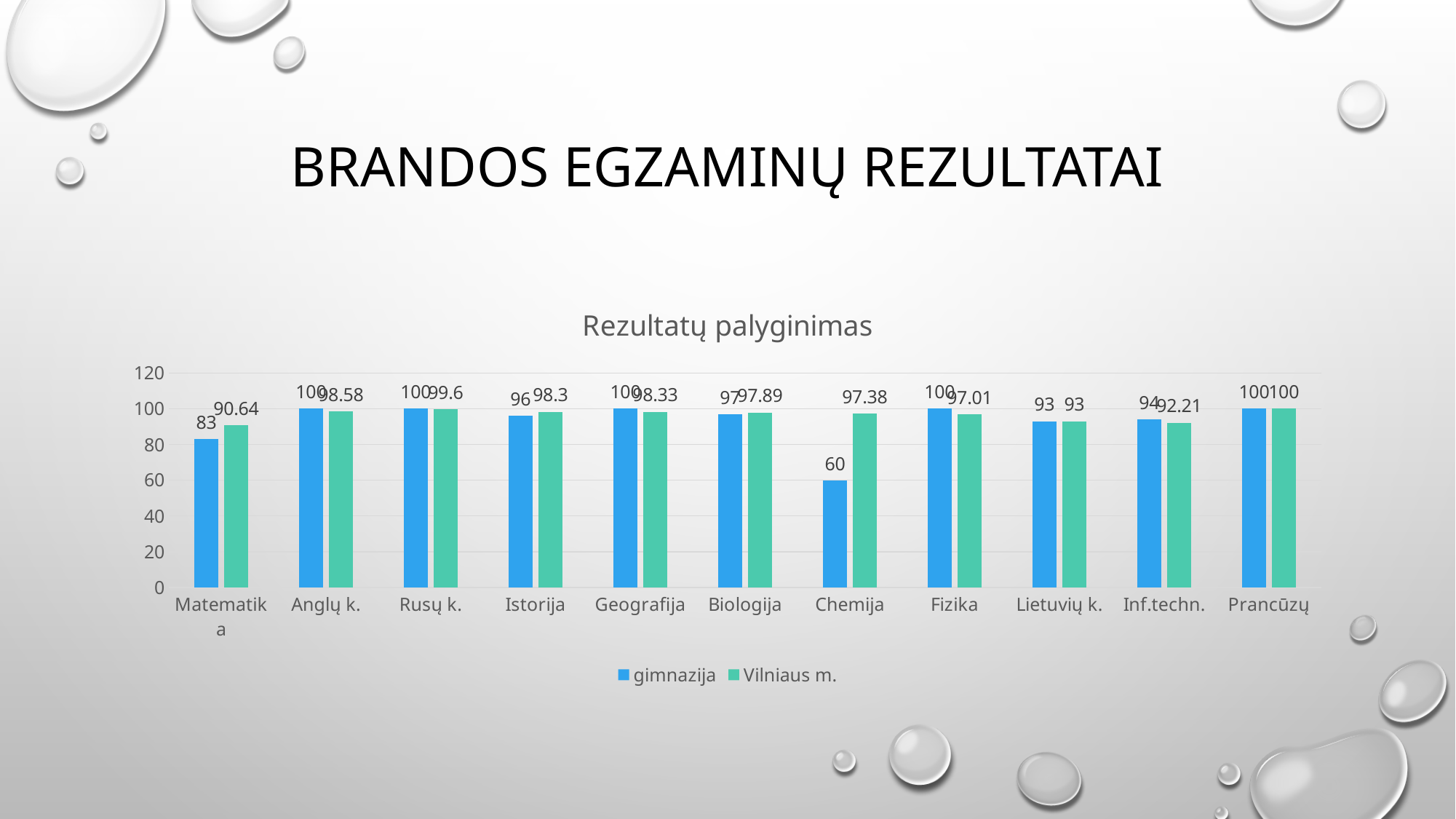
What is the Vilniaus m. value for Inf.techn.? 92.21 How many categories are shown on the x axis? 11 How many series does the legend list? 2 For Istorija, which is larger: the gimnazija value or the Vilniaus m. value? Vilniaus m. What is the difference between the Vilniaus m. and gimnazija values for Chemija? 37.38 What is the Vilniaus m. value for Matematika? 90.64 What is the difference between the Vilniaus m. and gimnazija values for Matematika? 7.64 What is the gimnazija value for Chemija? 60 Which category has the lowest Vilniaus m. value? Matematika What is the title of the chart? Rezultatų palyginimas What kind of chart is shown on the slide? bar chart Which category has the lowest gimnazija value? Chemija